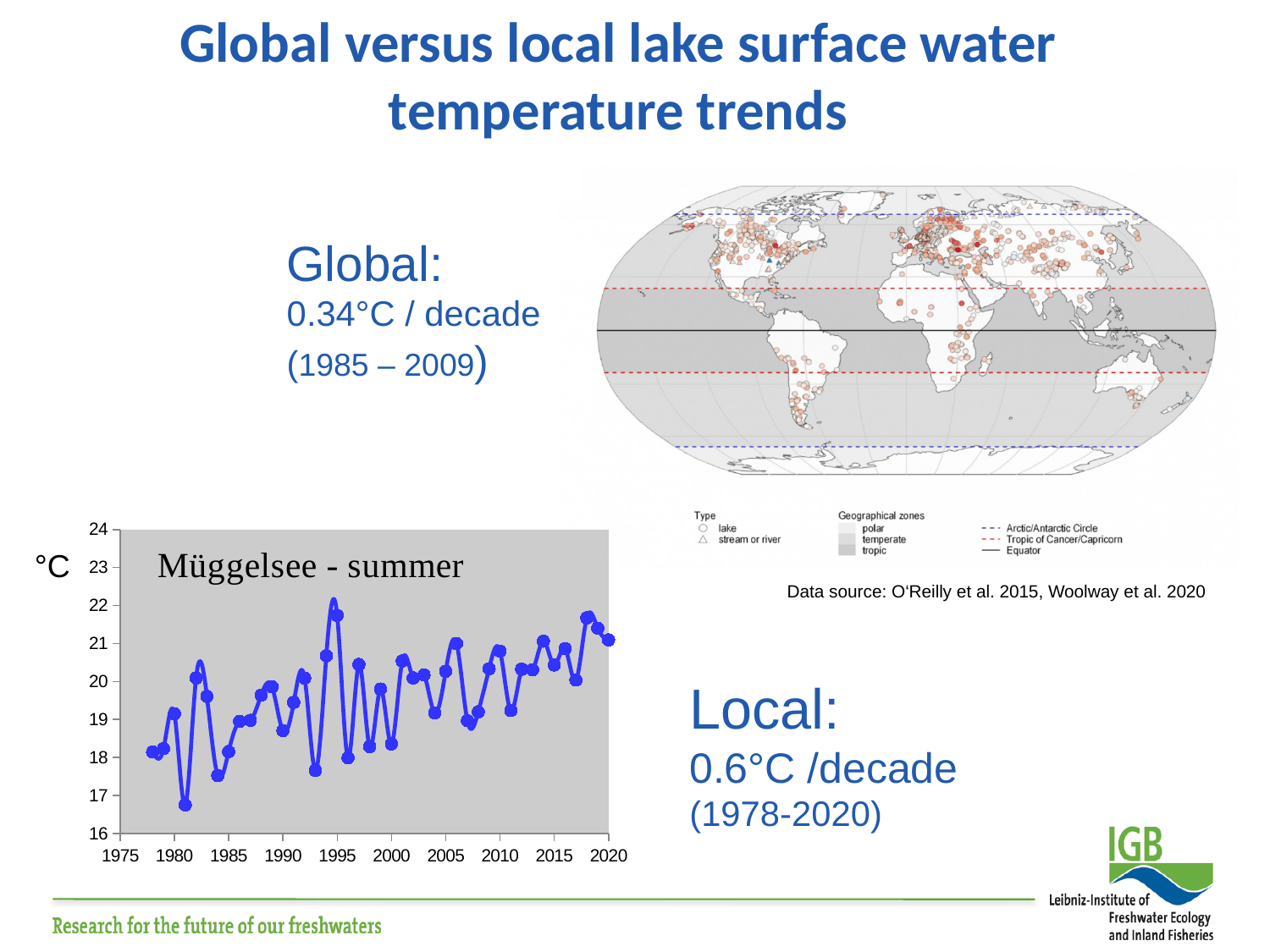
On the Müggelsee - summer chart, is the value for 2020 greater or less than 20? greater What unit is shown on the y axis of the Müggelsee - summer chart? °C On the Müggelsee - summer chart, is the value for 1978 greater or less than 19? less On the Müggelsee - summer chart, what is the last year labelled on the x axis? 2020 On the Müggelsee - summer chart, do the values generally rise or fall from 1978 to 2020? rise On the Müggelsee - summer chart, what is the first year labelled on the x axis? 1975 What is the title of the line chart in the lower left of the slide? Müggelsee - summer What kind of chart is the Müggelsee - summer chart? line chart On the Müggelsee - summer chart, what is the lowest value shown on the y axis? 16 On the Müggelsee - summer chart, is the lowest plotted value greater or less than 18? less On the Müggelsee - summer chart, what is the highest value shown on the y axis? 24